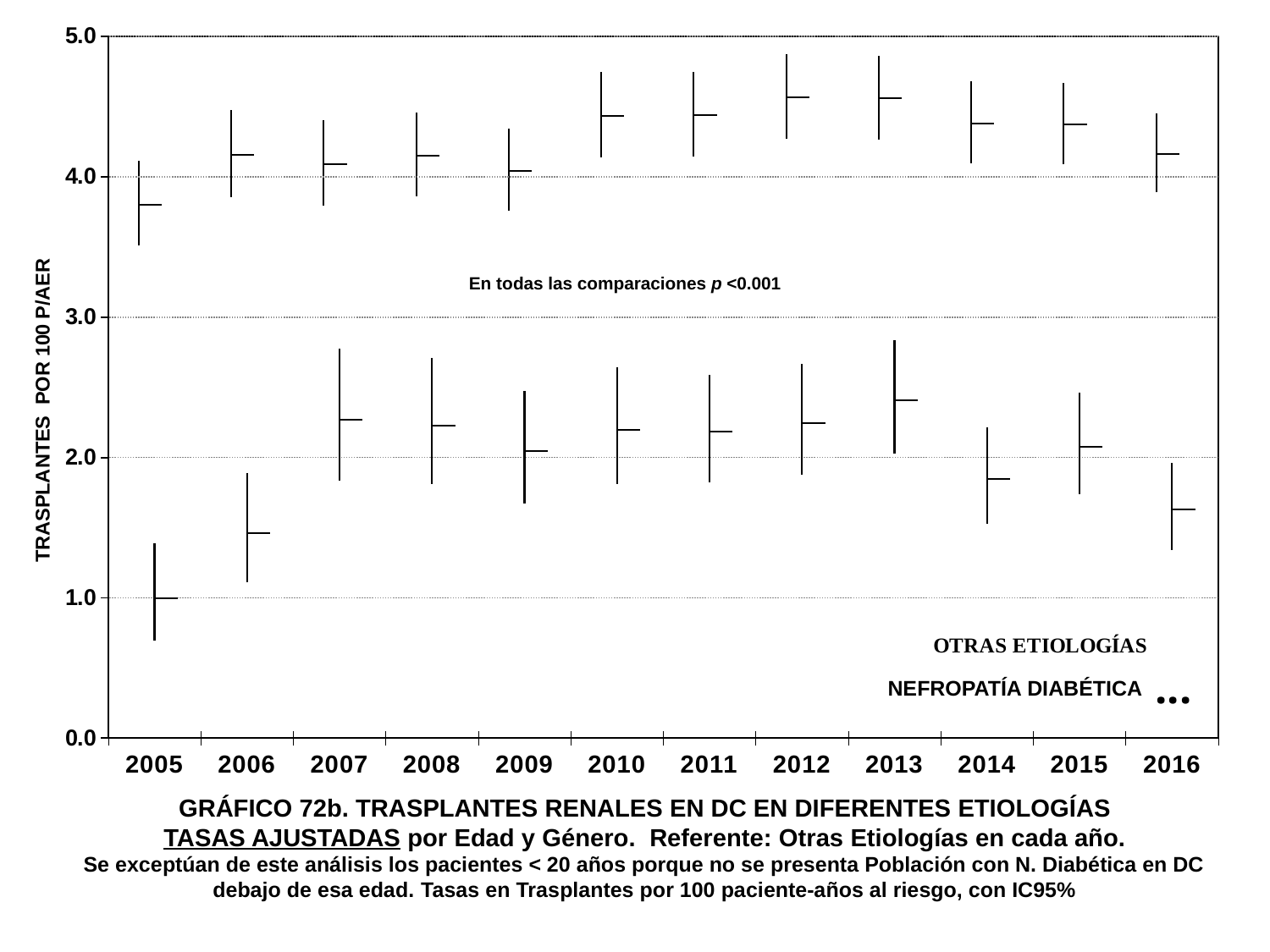
Which series has the lower values throughout the chart? NEFROPATÍA DIABÉTICA How many series does the legend list? 2 In which year is the OTRAS ETIOLOGÍAS rate lowest? 2005 Does the NEFROPATÍA DIABÉTICA rate rise or fall from 2013 to 2016? fall Is the OTRAS ETIOLOGÍAS value for 2005 greater or less than 4.0? less In which year is the NEFROPATÍA DIABÉTICA rate lowest? 2005 How many years are shown on the x axis? 12 Is the NEFROPATÍA DIABÉTICA value for 2007 greater or less than 2.0? greater Is the NEFROPATÍA DIABÉTICA value for 2016 greater or less than 2.0? less What is the label of the y axis? TRASPLANTES POR 100 P/AER In which year is the NEFROPATÍA DIABÉTICA rate highest? 2013